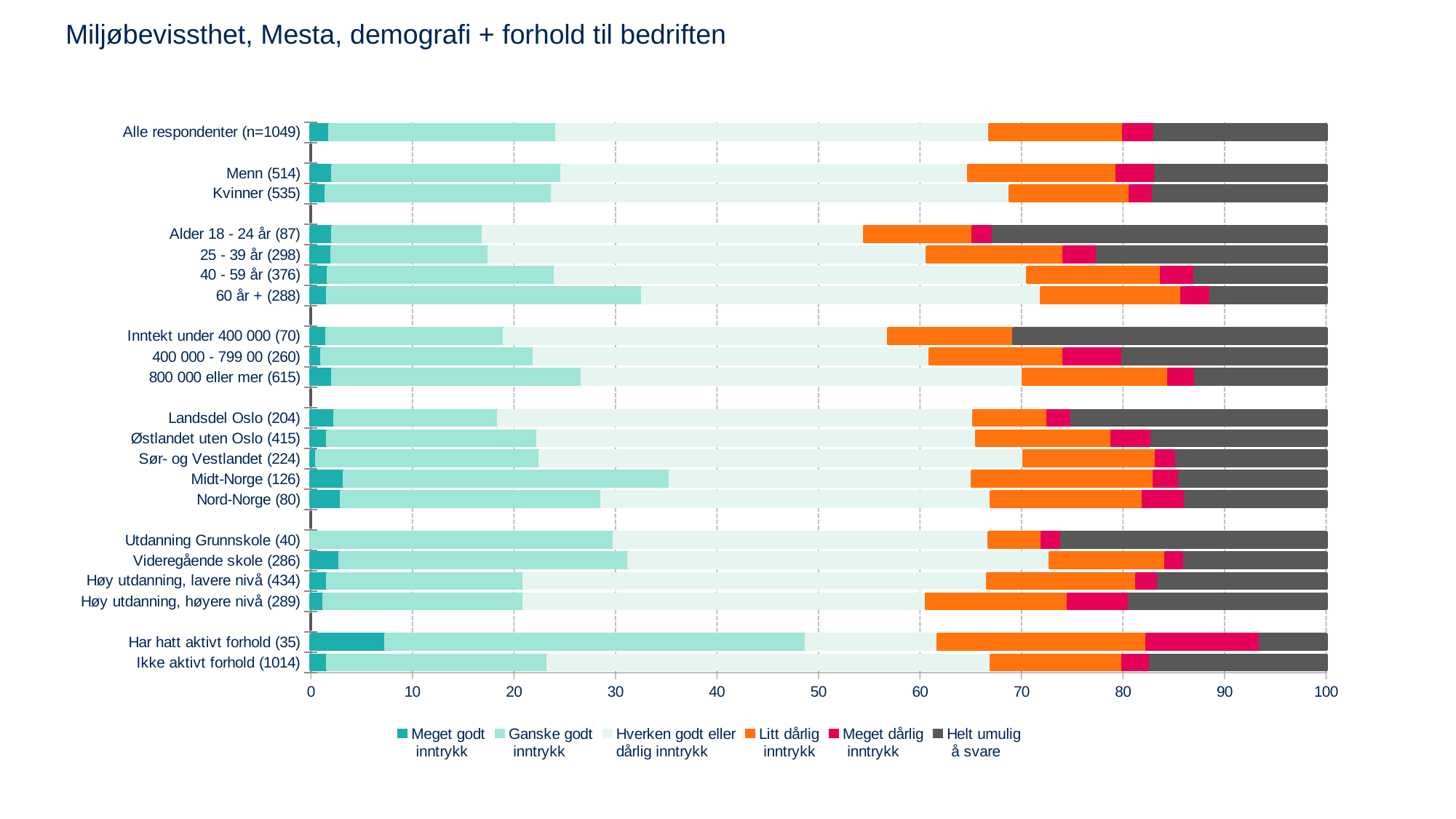
Which category has the largest 'Meget dårlig inntrykk' segment? Har hatt aktivt forhold (35) Which category has the largest 'Ganske godt inntrykk' segment? Har hatt aktivt forhold (35) Is the 'Ganske godt inntrykk' value for Har hatt aktivt forhold (35) greater or less than 30? greater Which legend entry is shown in dark grey? Helt umulig å svare How many categories (bars) are plotted in the chart? 21 Is the 'Meget godt inntrykk' value for Har hatt aktivt forhold (35) greater or less than 10? less What is the title of the chart? Miljøbevissthet, Mesta, demografi + forhold til bedriften Which category has the largest 'Meget godt inntrykk' segment? Har hatt aktivt forhold (35) Which has the larger 'Meget godt inntrykk' segment, Midt-Norge (126) or Kvinner (535)? Midt-Norge (126) How many series does the legend list? 6 What kind of chart is shown on the slide? Stacked bar chart Which category has the smallest 'Helt umulig å svare' segment? Har hatt aktivt forhold (35)